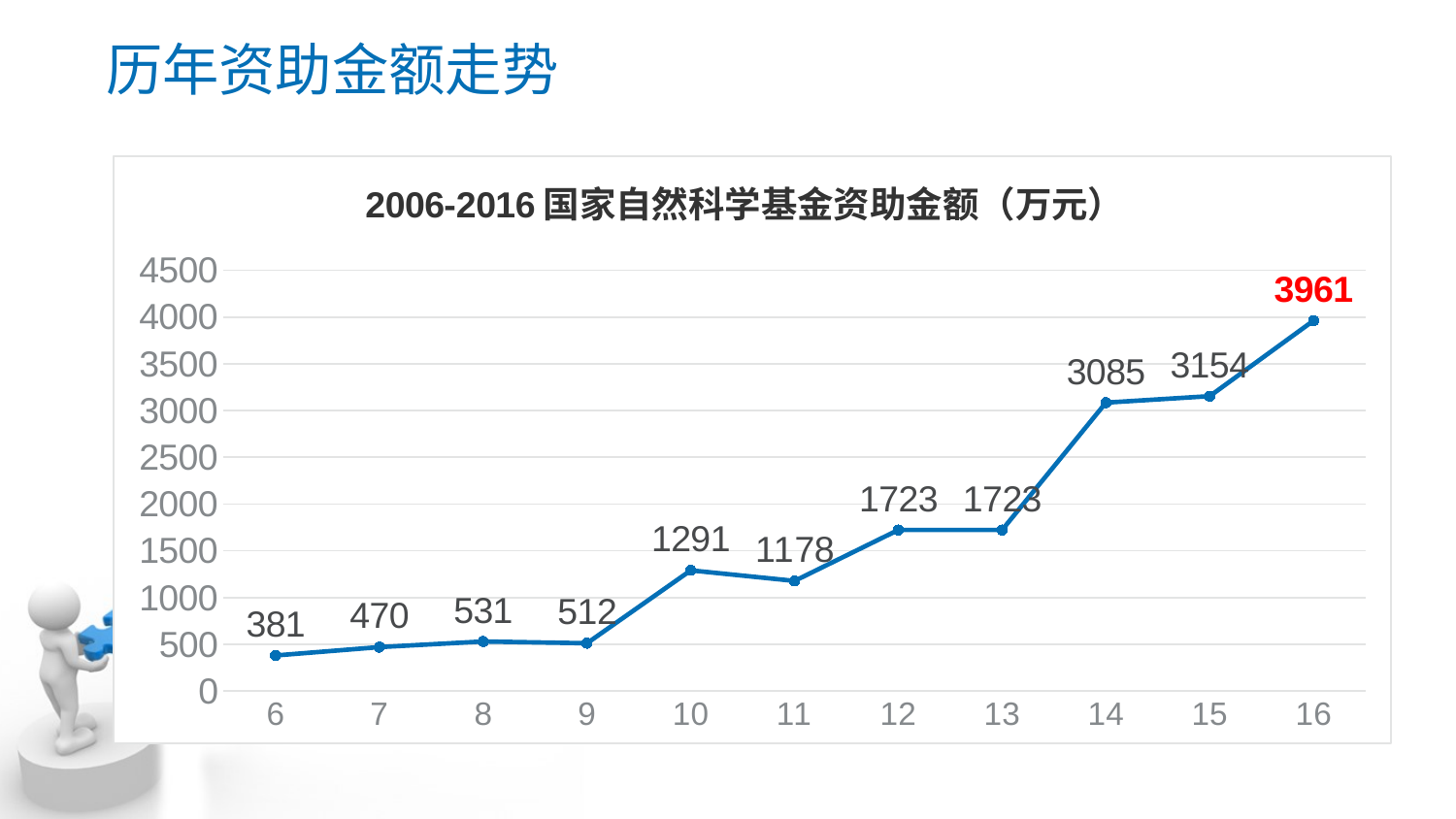
How many data points are plotted on the chart? 11 Which is larger, the value for category 10 or the value for category 11? 10 Which category has the lowest value? 6 Do the values generally rise or fall from category 6 to category 16? rise What is the value for category 14? 3085 What is the title of the chart? 2006-2016 国家自然科学基金资助金额（万元） Is the value for category 14 greater or less than 3000? greater What is the value for category 10? 1291 What kind of chart is shown on the slide? line chart What is the difference between the values for category 16 and category 15? 807 What is the value for category 6? 381 Which category has the highest value? 16